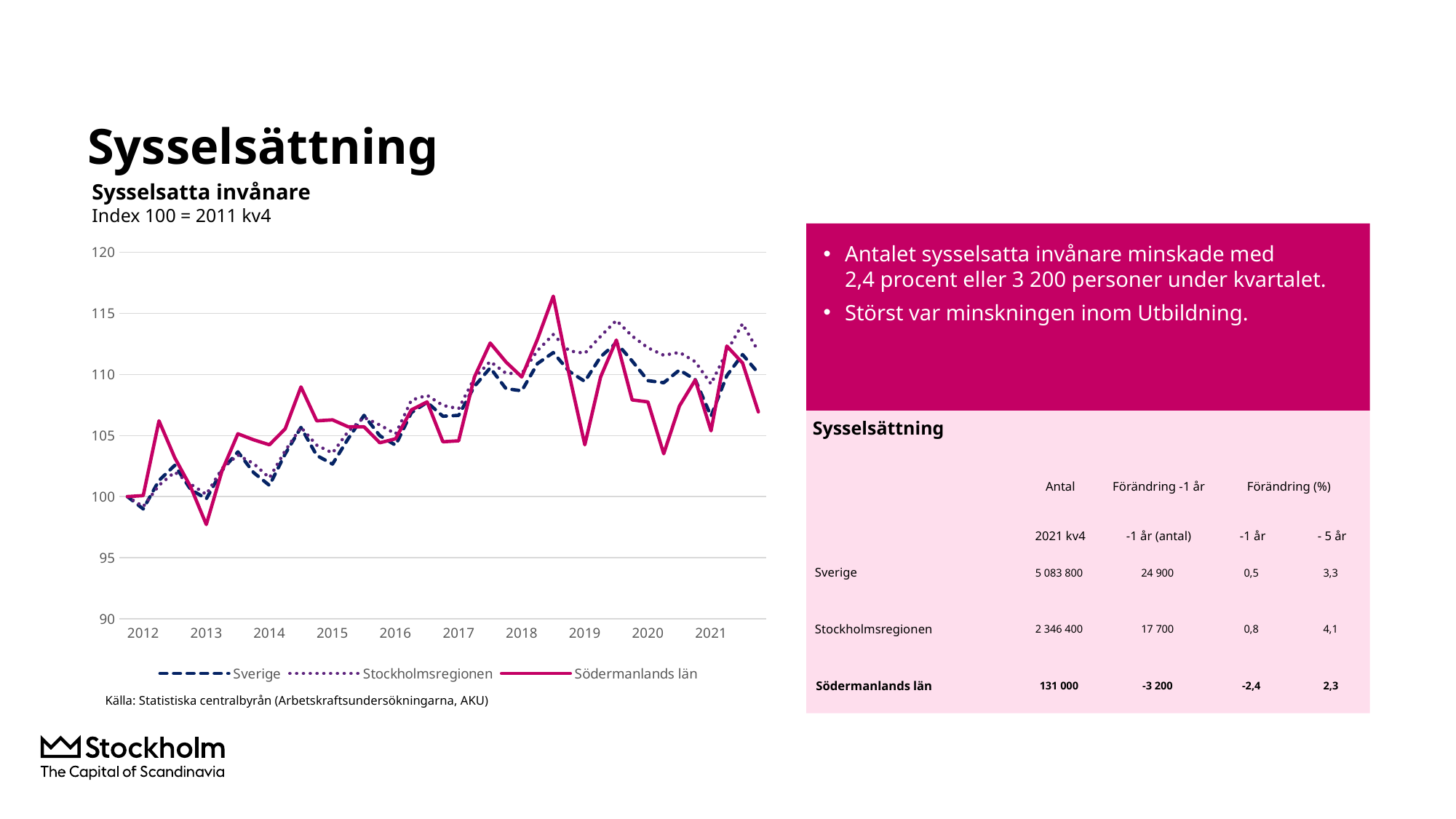
Which series reaches the highest point anywhere on the chart? Södermanlands län Is the peak value for Södermanlands län in 2018 greater or less than 115? greater Overall, do the index values rise or fall from 2012 to 2021? rise At the end of 2021, which is higher: Stockholmsregionen or Södermanlands län? Stockholmsregionen What is the title of the chart? Sysselsatta invånare How many series does the chart legend list? 3 What kind of chart is shown on the slide? line chart How many years are labelled on the x axis of the chart? 10 Is the value for Sverige at the end of 2021 greater or less than 105? greater Is the lowest value for Södermanlands län in 2013 greater or less than 100? less Which series are listed in the chart legend? Sverige, Stockholmsregionen, Södermanlands län Which series has the lowest value at the end of 2021? Södermanlands län